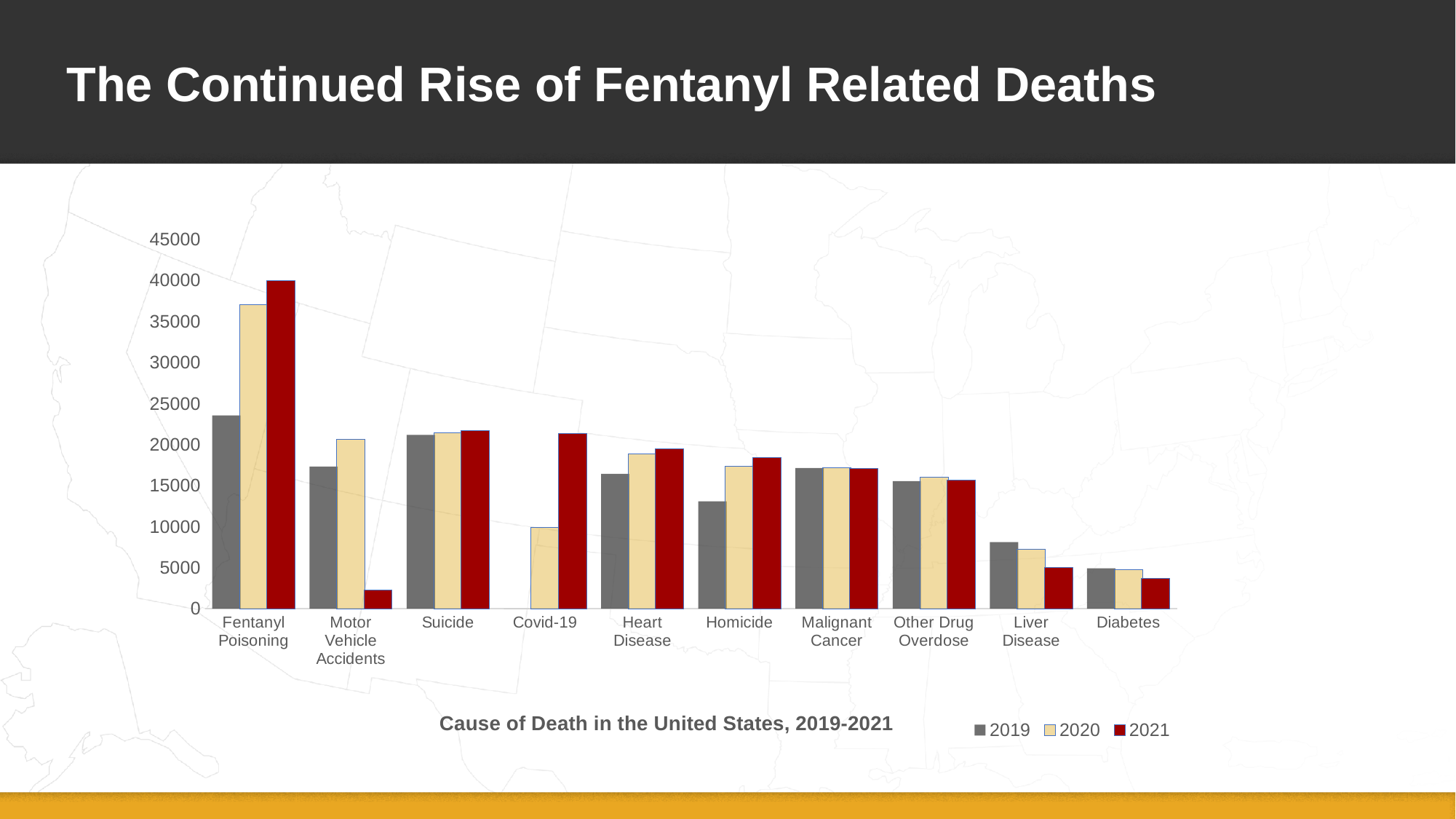
What kind of chart is shown on the slide? Bar chart Which cause of death has the lowest 2021 bar? Motor Vehicle Accidents Is the 2021 value for Motor Vehicle Accidents greater or less than 5000? less Do the values for Fentanyl Poisoning rise or fall from 2019 to 2021? Rise What is the title printed below the chart? Cause of Death in the United States, 2019-2021 Which cause of death has the highest 2021 bar? Fentanyl Poisoning How many causes of death are shown on the x axis of the chart? 10 How many series does the chart's legend list? 3 Is the 2021 value for Fentanyl Poisoning greater or less than 35000? greater Is the 2020 value for Covid-19 greater or less than 15000? less Which cause of death has the lowest 2020 bar? Diabetes Which is larger, the 2020 value for Fentanyl Poisoning or the 2020 value for Suicide? Fentanyl Poisoning